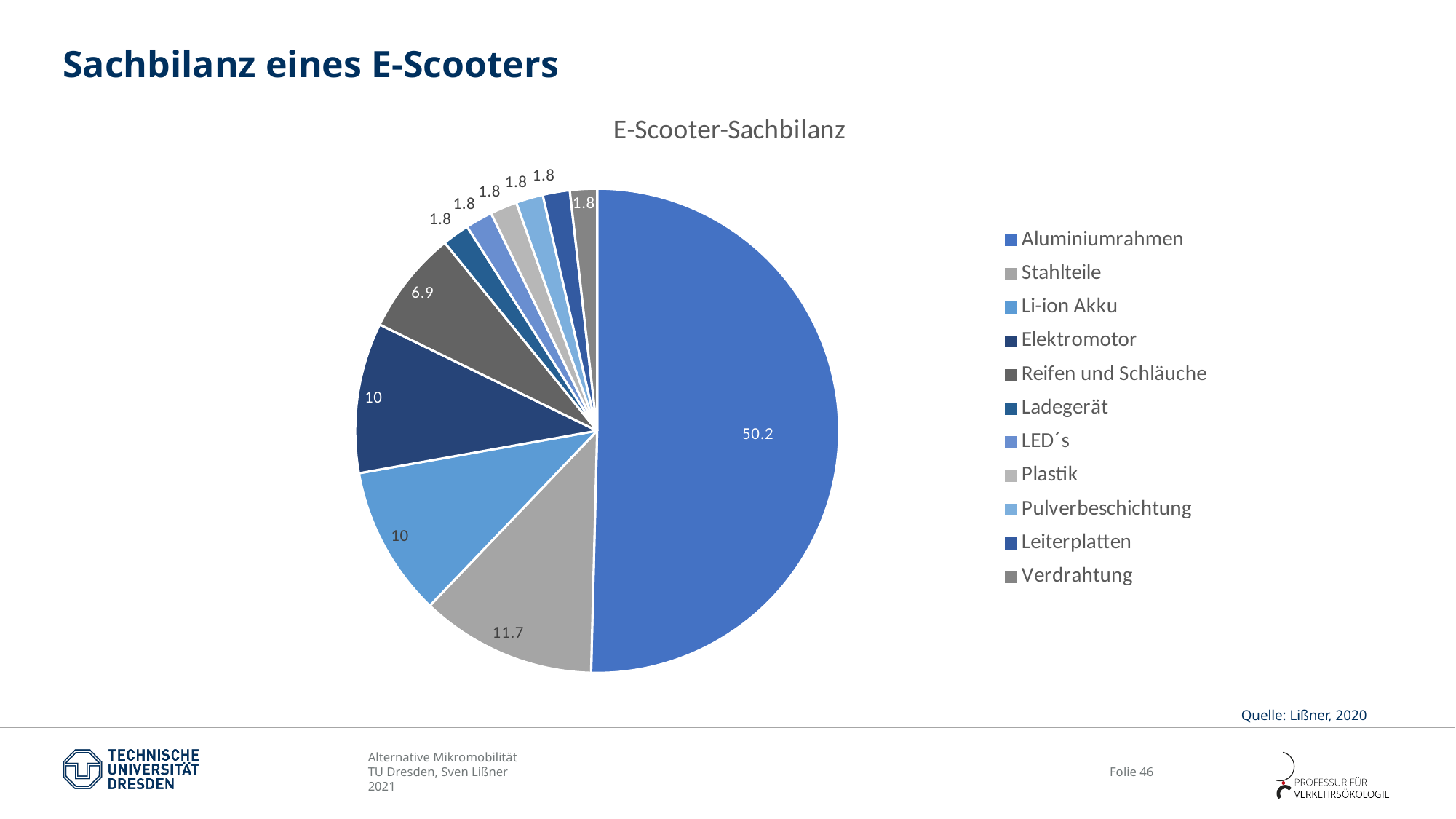
What is the value for Verdrahtung in the pie chart? 1.8 What is the value for Reifen und Schläuche in the pie chart? 6.9 What type of chart is shown on the slide? pie chart Which category has the largest slice in the pie chart? Aluminiumrahmen What is the value for Aluminiumrahmen in the E-Scooter-Sachbilanz pie chart? 50.2 What is the difference between the values for Aluminiumrahmen and Stahlteile? 38.5 What is the title of the pie chart? E-Scooter-Sachbilanz Which is larger, the value for Elektromotor or the value for Reifen und Schläuche? Elektromotor What is the value for Stahlteile in the pie chart? 11.7 How many categories does the legend of the pie chart list? 11 What is the value for Li-ion Akku in the pie chart? 10 What is the difference between the values for Stahlteile and Reifen und Schläuche? 4.8